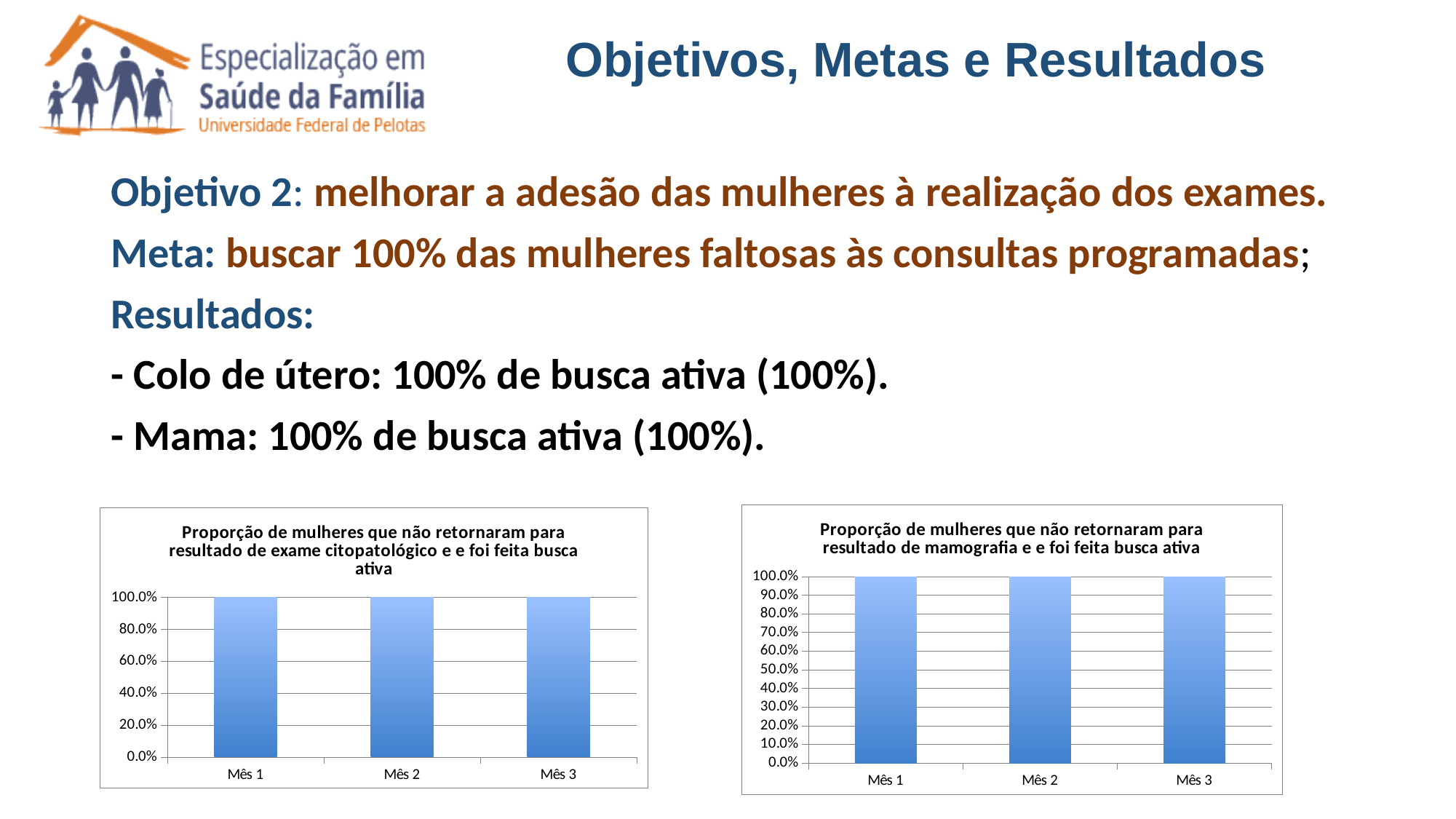
In the right chart (mamografia), what is the value for Mês 2? 100.0% In the right chart (mamografia), do the values rise, fall or stay the same from Mês 1 to Mês 3? stay the same In the left chart (exame citopatológico), what is the value for Mês 3? 100.0% In the right chart (mamografia), is the value for Mês 1 greater or less than 50.0%? greater In the left chart (exame citopatológico), is the value for Mês 2 greater or less than 80.0%? greater What kind of chart is the right chart (mamografia)? bar chart In the left chart (exame citopatológico), how many categories are shown on the x axis? 3 In the right chart (mamografia), how many bars are plotted? 3 What kind of chart is the left chart (exame citopatológico)? bar chart In the right chart (mamografia), what is the value for Mês 3? 100.0% In the left chart (exame citopatológico), what is the value for Mês 1? 100.0% In the left chart (exame citopatológico), what is the difference between the values for Mês 1 and Mês 3? 0.0%